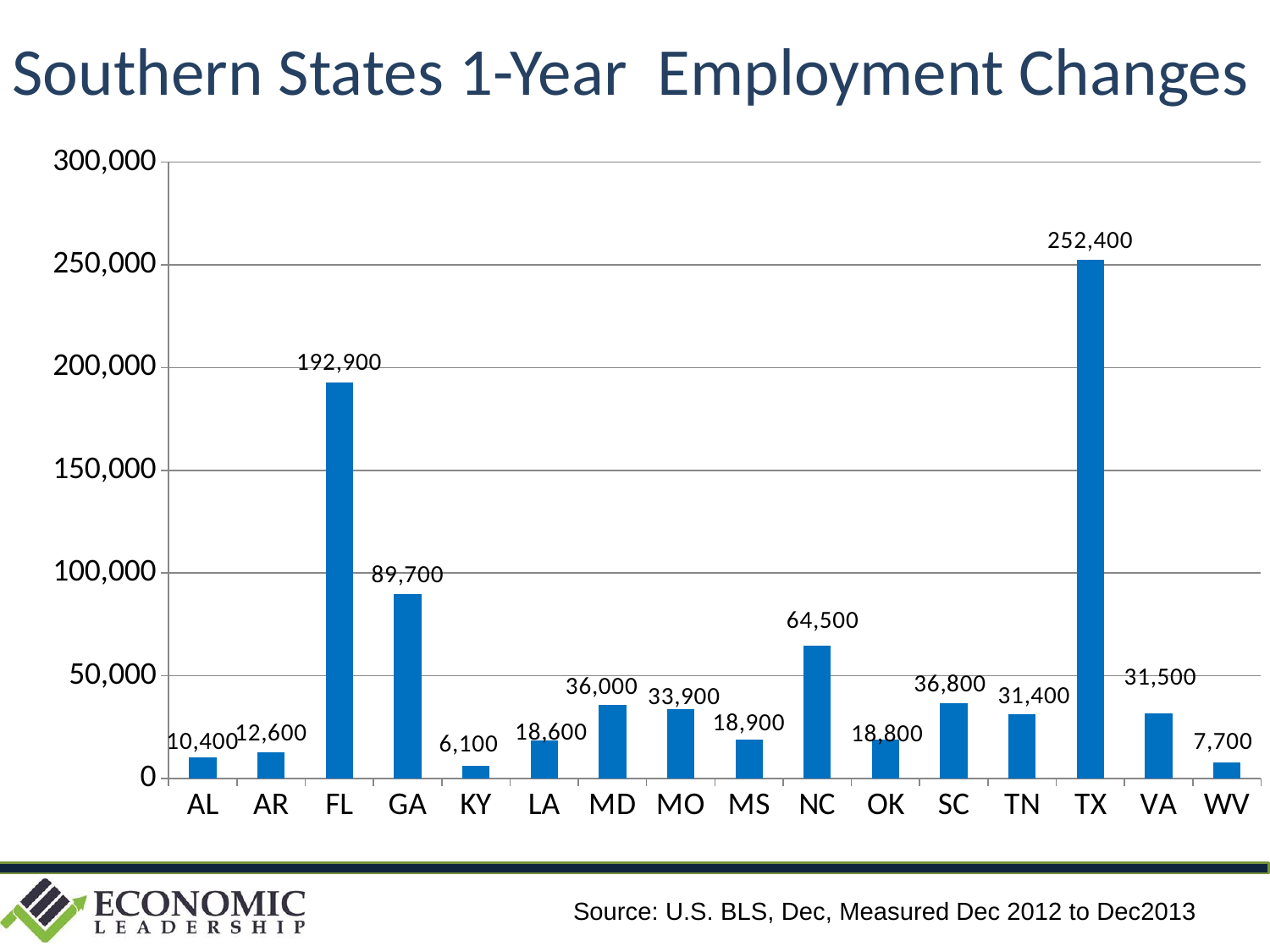
What kind of chart is shown on the slide? Bar chart Which state has a larger employment change, SC or TN? SC What is the 1-year employment change for KY? 6,100 Is the value for FL greater or less than 200,000? less Which state has the lowest 1-year employment change? KY What is the 1-year employment change for TX? 252,400 What is the difference between the employment changes for GA and NC? 25,200 What is the difference between the employment changes for TX and FL? 59,500 What is the 1-year employment change for NC? 64,500 How many states are shown on the x axis? 16 Which state has the highest 1-year employment change? TX What is the title of the chart? Southern States 1-Year Employment Changes